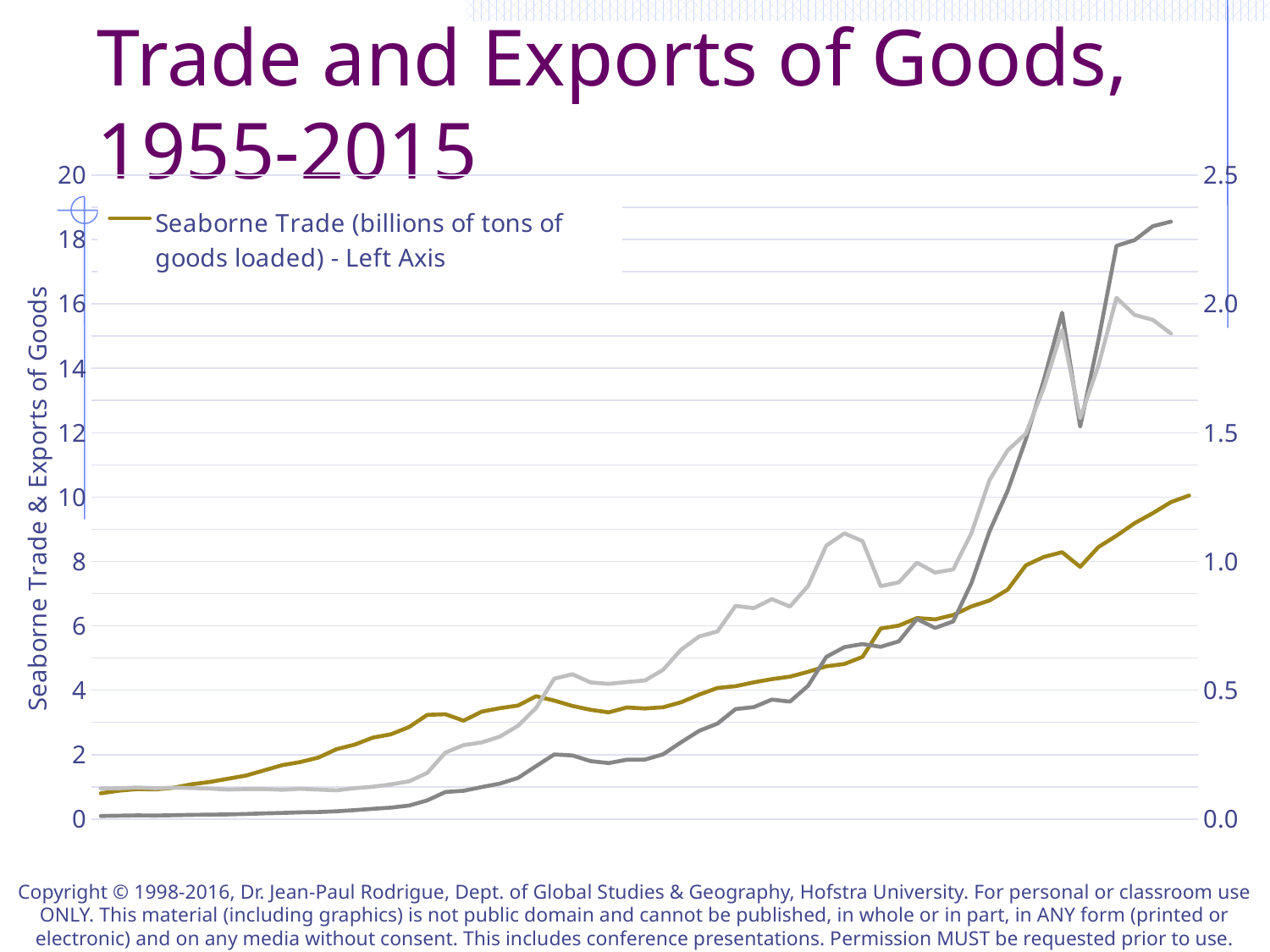
Is the Seaborne Trade value at the leftmost point of the chart greater or less than 2? less What is the title of the chart on the slide? Trade and Exports of Goods, 1955-2015 On which axis is the Seaborne Trade series plotted? Left Axis How many lines are plotted on the chart? 3 Is the Seaborne Trade value at the rightmost point of the chart greater or less than 6? greater Is the Seaborne Trade value at the rightmost point of the chart greater or less than 8? greater What kind of chart is shown on the slide? line chart Does the Seaborne Trade line rise or fall from left to right across the chart? rise